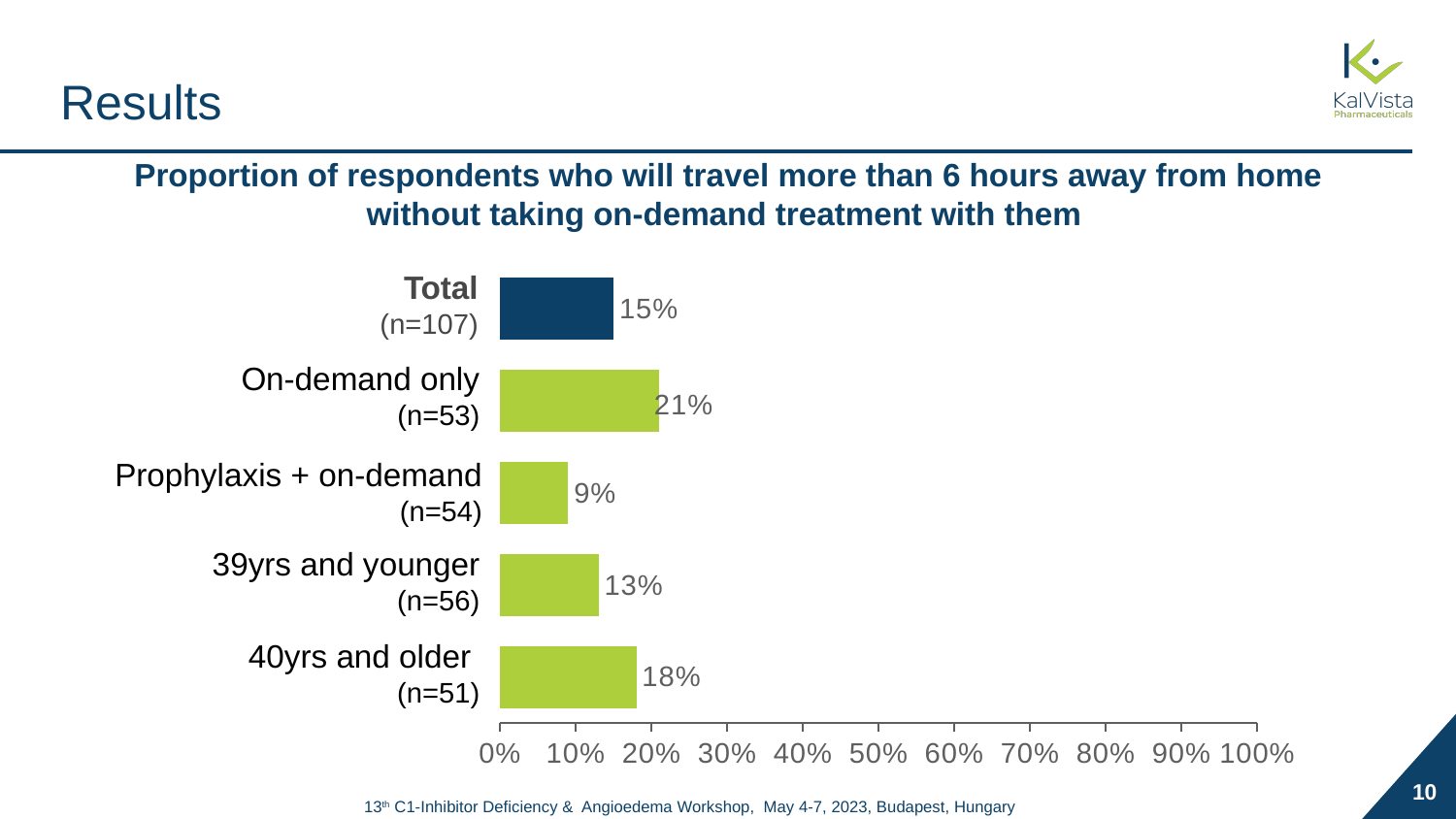
What is the value for Total (n=107)? 15% Which category has the lowest value? Prophylaxis + on-demand What is the value for 39yrs and younger (n=56)? 13% How many categories are shown in the chart? 5 What is the title of the chart? Proportion of respondents who will travel more than 6 hours away from home without taking on-demand treatment with them What is the value for On-demand only (n=53)? 21% Which is larger, the value for 40yrs and older or the value for 39yrs and younger? 40yrs and older What is the difference between the values for On-demand only and Prophylaxis + on-demand? 12% What kind of chart is shown on the slide? Bar chart What is the value for Prophylaxis + on-demand (n=54)? 9% What is the value for 40yrs and older (n=51)? 18% Which category has the highest value? On-demand only